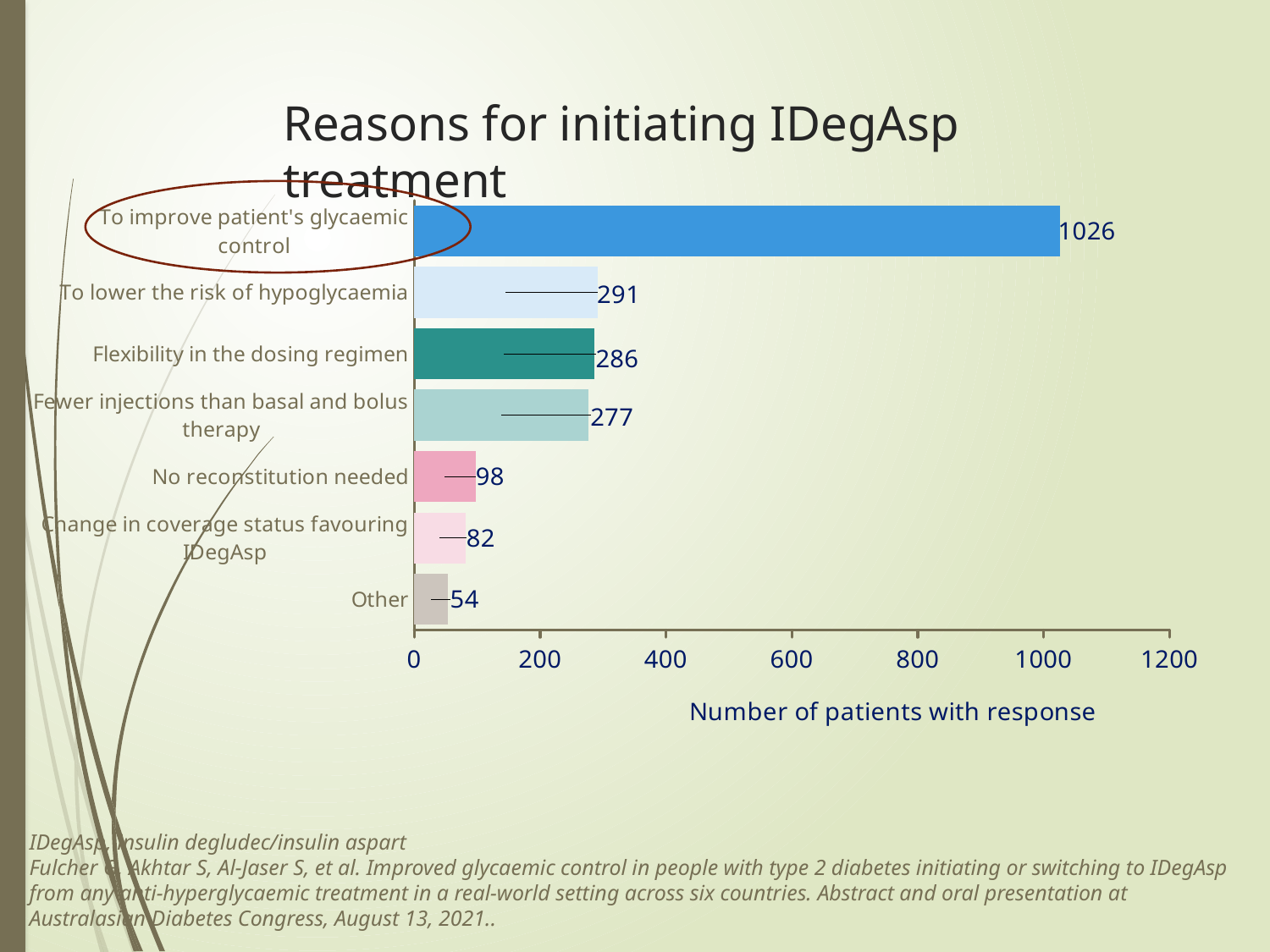
What value is shown for "No reconstitution needed"? 98 Which category has the lowest number of patients with response? Other What is the number of patients with the response "Flexibility in the dosing regimen"? 286 What is the difference between the highest value and the value for "Other"? 972 Which reason for initiating IDegAsp treatment has the highest number of patients? To improve patient's glycaemic control What is the label of the horizontal axis of the chart? Number of patients with response What type of chart is shown on the slide? Bar chart Is the value for "Fewer injections than basal and bolus therapy" greater or less than 200? greater How many reasons (categories) are shown in the chart? 7 How many patients gave "To improve patient's glycaemic control" as a reason for initiating IDegAsp treatment? 1026 What is the difference between the number of patients citing "To lower the risk of hypoglycaemia" and those citing "Fewer injections than basal and bolus therapy"? 14 Which has more patients: "No reconstitution needed" or "Change in coverage status favouring IDegAsp"? No reconstitution needed